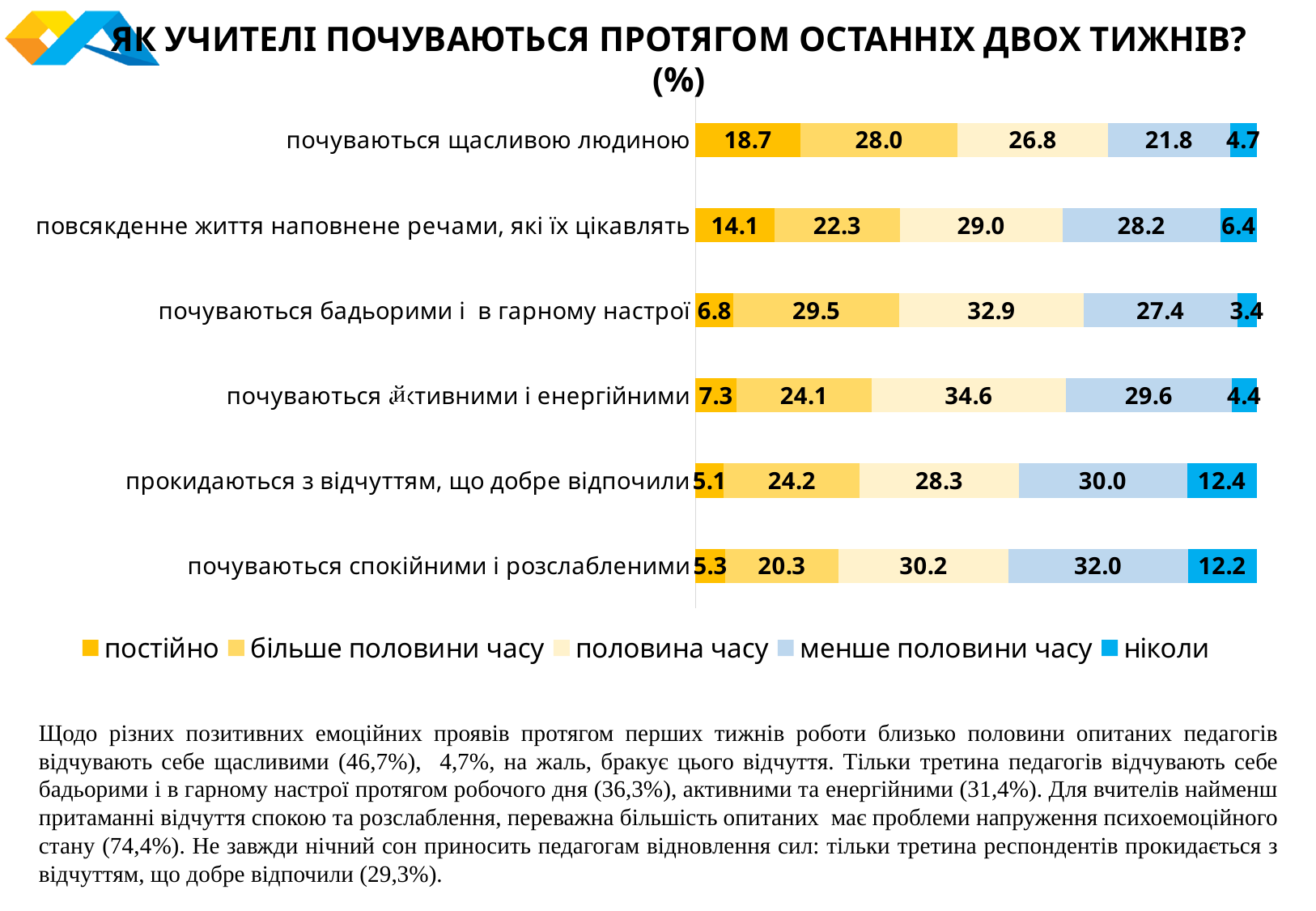
What kind of chart is shown on the slide? stacked bar chart What is the difference between the "менше половини часу" values for "почуваються спокійними і розслабленими" and "почуваються щасливою людиною"? 10.2 Which legend entry is shown in the darkest blue colour? ніколи Which is larger: the "більше половини часу" value for "почуваються бадьорими і в гарному настрої" or for "повсякденне життя наповнене речами, які їх цікавлять"? почуваються бадьорими і в гарному настрої What is the value of "половина часу" for "почуваються активними і енергійними"? 34.6 What is the total of the stacked bar for "почуваються щасливою людиною"? 100.0 Which category has the lowest value for "ніколи"? почуваються бадьорими і в гарному настрої What is the value of "ніколи" for "прокидаються з відчуттям, що добре відпочили"? 12.4 Which category has the highest value for "постійно"? почуваються щасливою людиною What is the value of "постійно" for "почуваються щасливою людиною"? 18.7 How many categories (statements) are plotted in the chart? 6 How many series does the legend list? 5